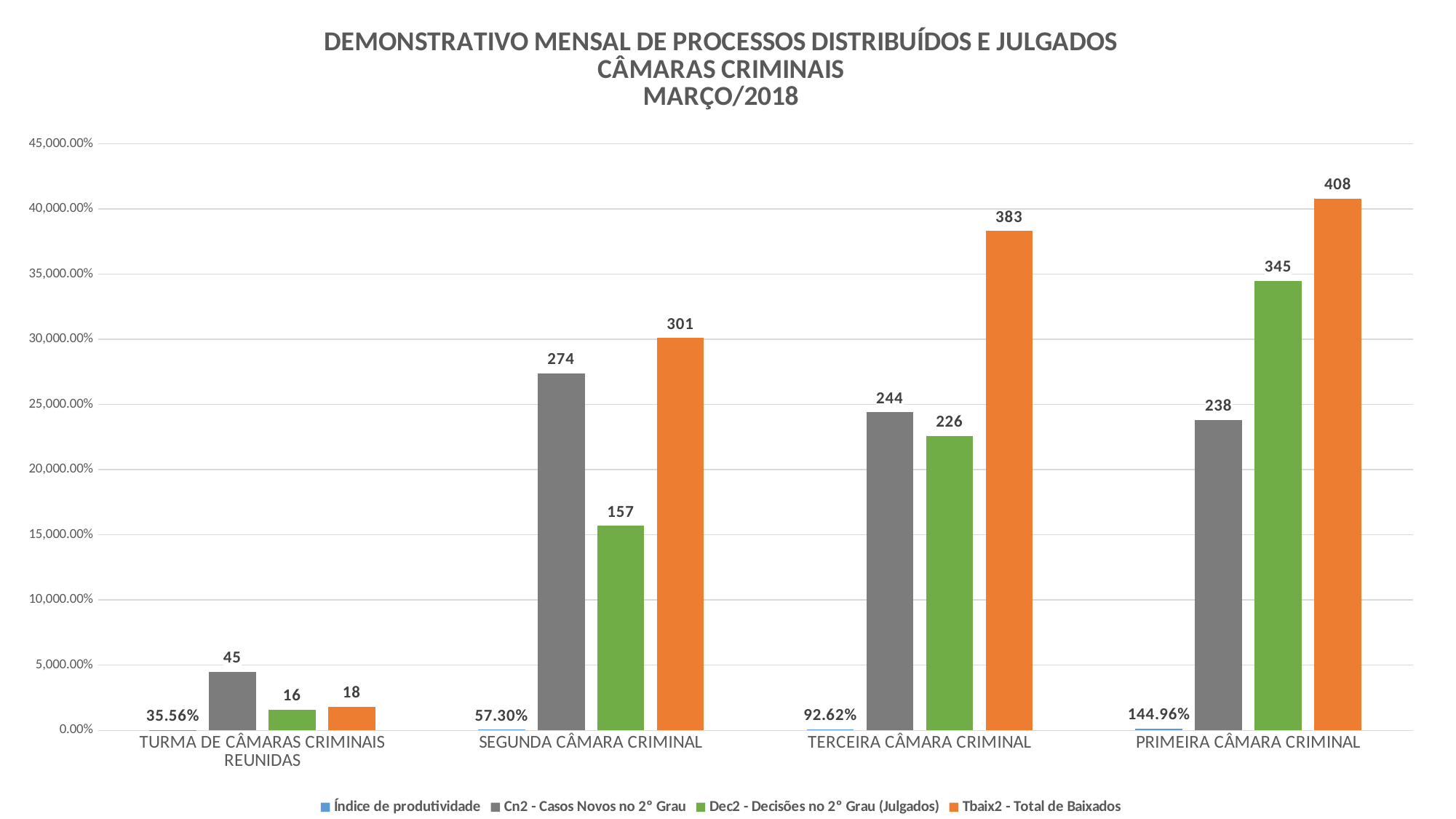
What is the difference between Tbaix2 - Total de Baixados for PRIMEIRA CÂMARA CRIMINAL and TERCEIRA CÂMARA CRIMINAL? 25 Which category has the lowest Cn2 - Casos Novos no 2° Grau value? TURMA DE CÂMARAS CRIMINAIS REUNIDAS What kind of chart is shown on the slide? Bar chart How many series does the legend list? 4 How many categories are shown on the x axis? 4 Which is larger for SEGUNDA CÂMARA CRIMINAL: Cn2 - Casos Novos no 2° Grau or Dec2 - Decisões no 2° Grau (Julgados)? Cn2 - Casos Novos no 2° Grau Which colour represents Tbaix2 - Total de Baixados in the chart? Orange Which category has the highest Tbaix2 - Total de Baixados value? PRIMEIRA CÂMARA CRIMINAL What is the value of Cn2 - Casos Novos no 2° Grau for SEGUNDA CÂMARA CRIMINAL? 274 What is the value of Dec2 - Decisões no 2° Grau (Julgados) for TURMA DE CÂMARAS CRIMINAIS REUNIDAS? 16 What is the value of Tbaix2 - Total de Baixados for PRIMEIRA CÂMARA CRIMINAL? 408 What is the Índice de produtividade for TERCEIRA CÂMARA CRIMINAL? 92.62%